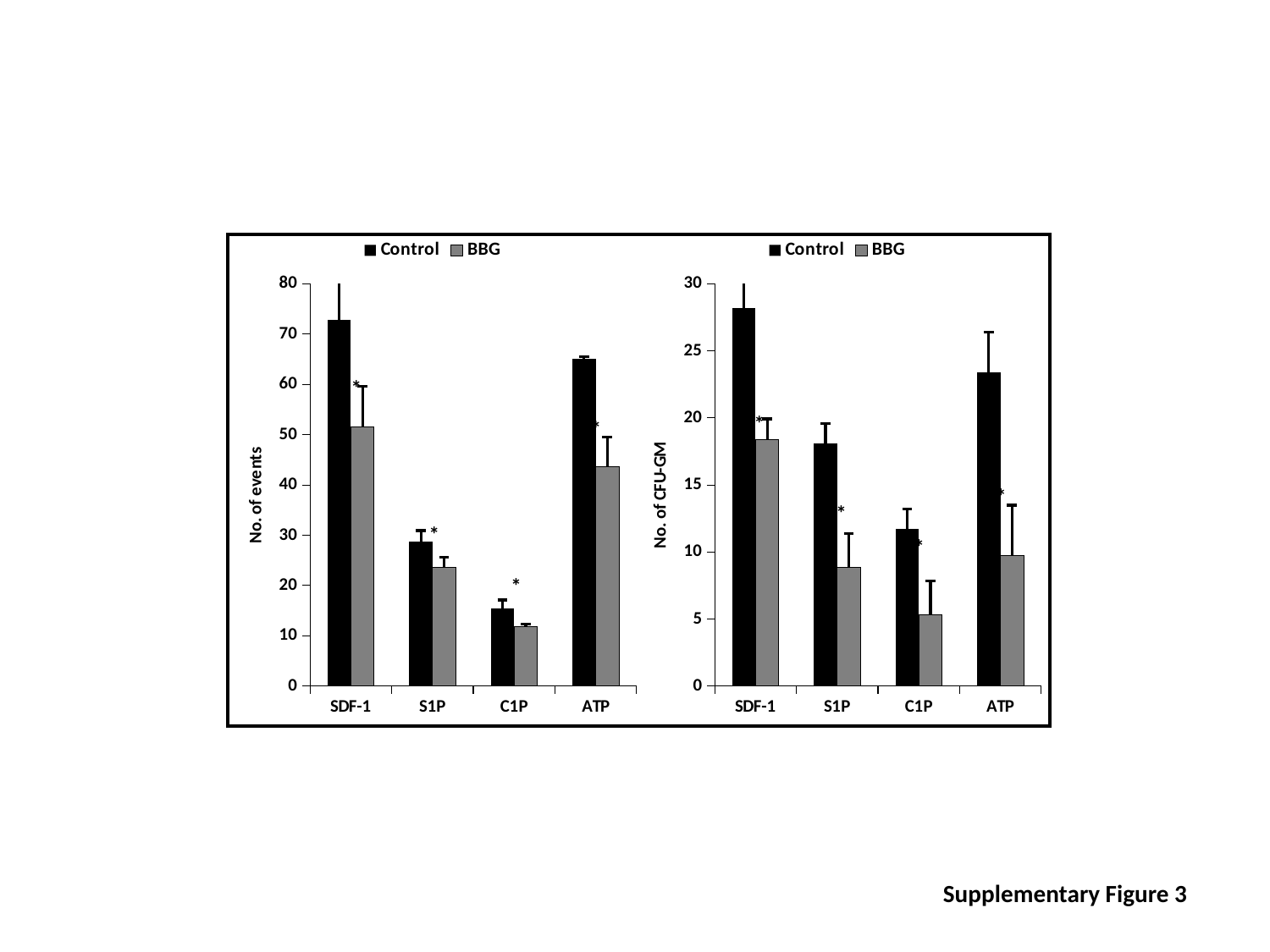
In the left chart (No. of events), which category has the lowest BBG value? C1P In the left chart (No. of events), which is larger for ATP: the Control value or the BBG value? Control In the right chart (No. of CFU-GM), is the BBG value for S1P greater or less than 10? less How many series does the legend of the right chart (No. of CFU-GM) list? 2 In the left chart (No. of events), which category has the highest Control value? SDF-1 What is the y-axis title of the right chart? No. of CFU-GM What kind of chart is the left chart (No. of events)? bar chart How many categories are shown on the x axis of the left chart (No. of events)? 4 In the right chart (No. of CFU-GM), which category has the lowest BBG value? C1P In the right chart (No. of CFU-GM), is the Control value for ATP greater or less than 20? greater In the right chart (No. of CFU-GM), which category has the highest Control value? SDF-1 In the left chart (No. of events), is the Control value for SDF-1 greater or less than 70? greater